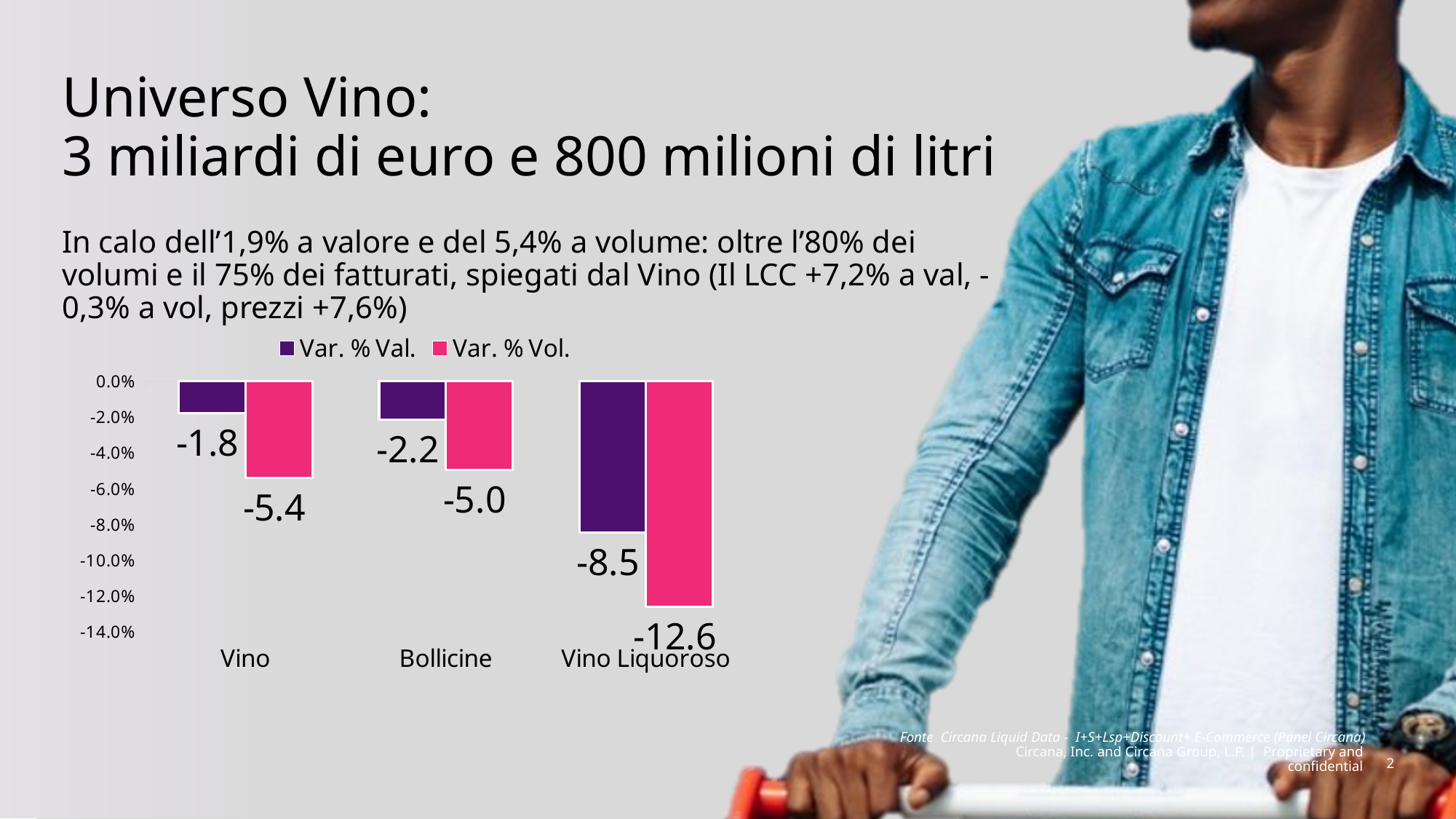
Which category has the lowest Var. % Vol. value? Vino Liquoroso Which is larger, the Var. % Vol. value for Vino or for Bollicine? Bollicine What kind of chart is shown on the slide? Bar chart How many categories are shown on the x axis of the chart? 3 What is the Var. % Vol. value for Vino Liquoroso? -12.6 What is the Var. % Val. value for Vino? -1.8 What is the difference between the Var. % Val. and Var. % Vol. values for Vino? 3.6 How many series does the chart legend list? 2 What are the two series names listed in the chart legend? Var. % Val. and Var. % Vol. Which category has the highest Var. % Val. value? Vino What is the Var. % Vol. value for Bollicine? -5.0 What is the Var. % Val. value for Vino Liquoroso? -8.5